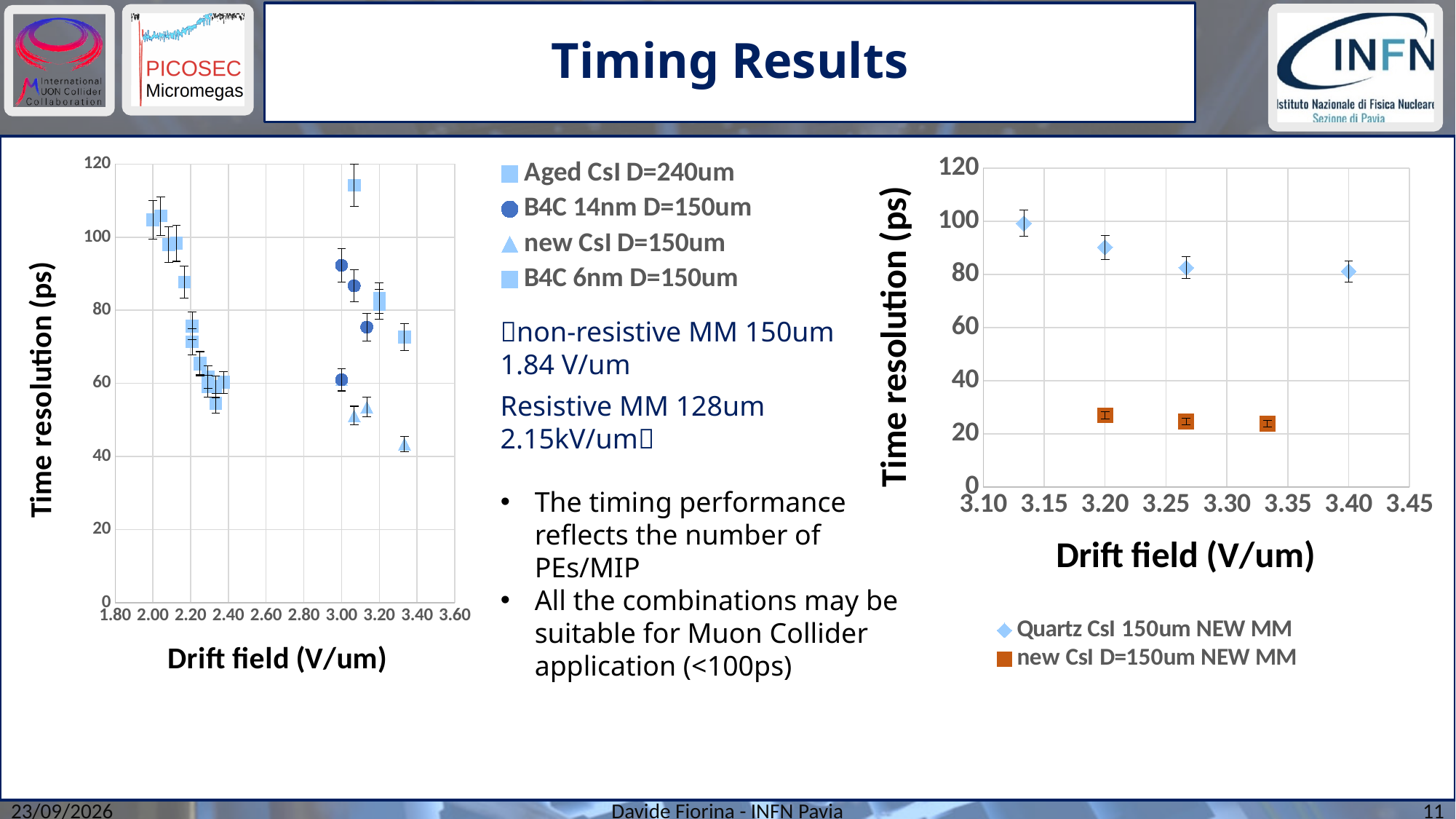
In the right chart, how many data points are plotted for the Quartz CsI 150um NEW MM series? 4 What is the y-axis title of the left chart? Time resolution (ps) What kind of chart is the chart on the right of the slide? scatter chart In the right chart, is the time resolution of Quartz CsI 150um NEW MM at a drift field of 3.20 V/um greater or less than 80 ps? greater How many series does the legend of the right chart list? 2 What kind of chart is the chart on the left of the slide? scatter chart In the right chart, is the time resolution of new CsI D=150um NEW MM at a drift field of 3.20 V/um greater or less than 40 ps? less In the right chart, does the time resolution of the Quartz CsI 150um NEW MM series rise or fall as the drift field increases? fall How many series does the legend of the left chart list? 4 In the left chart, is the time resolution of the new CsI D=150um point near 3.35 V/um greater or less than 60 ps? less In the right chart, at a drift field of 3.20 V/um, which series has the higher time resolution: Quartz CsI 150um NEW MM or new CsI D=150um NEW MM? Quartz CsI 150um NEW MM In the right chart, how many data points are plotted for the new CsI D=150um NEW MM series? 3